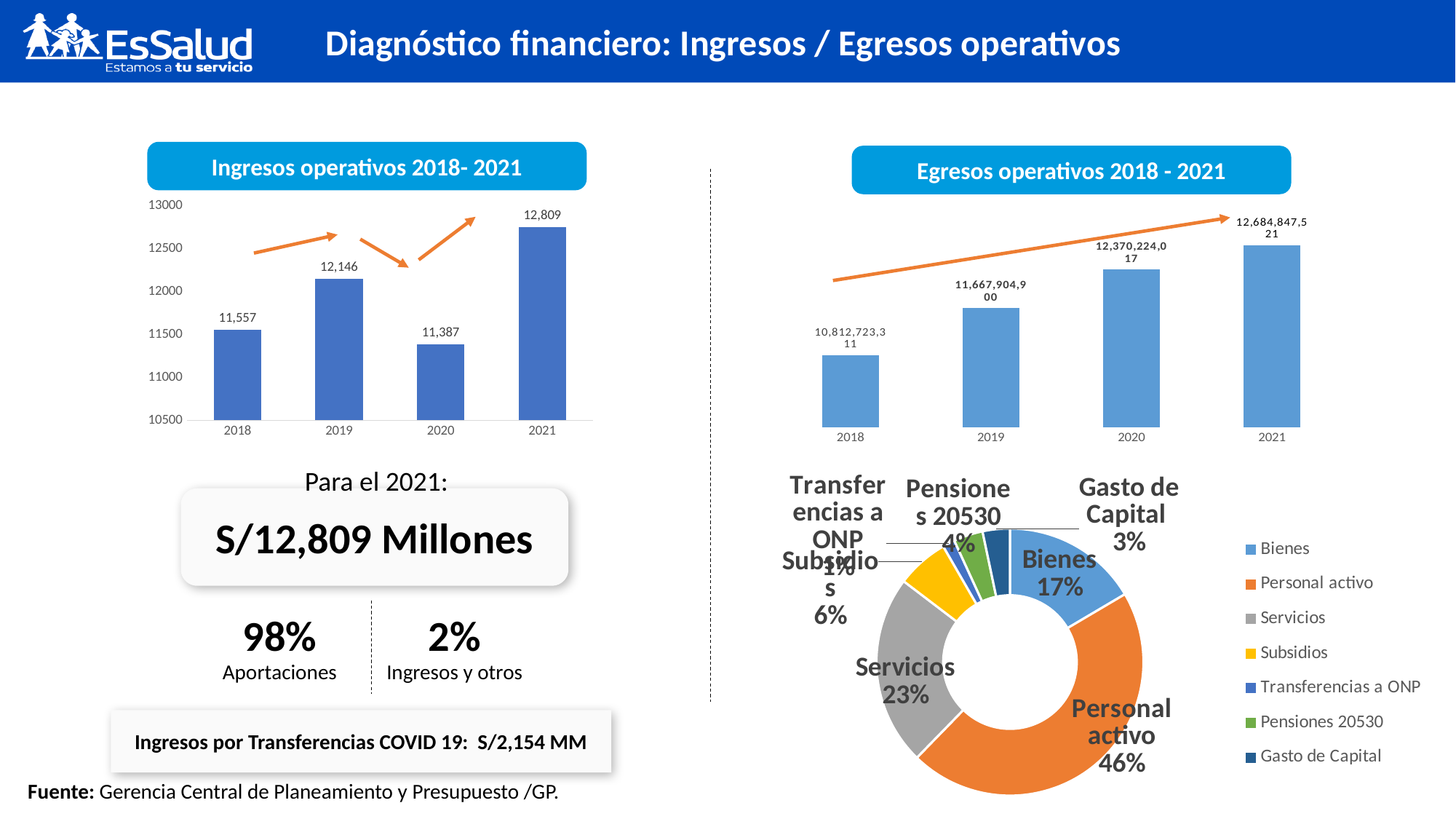
In the 'Ingresos operativos 2018- 2021' chart, which year has the highest value? 2021 What kind of chart is the 'Ingresos operativos 2018- 2021' chart? bar chart In the 'Ingresos operativos 2018- 2021' chart, which is larger, the value for 2019 or for 2020? 2019 In the 'Ingresos operativos 2018- 2021' chart, which year has the lowest value? 2020 In the donut chart at the bottom right, what share does 'Personal activo' have? 46% In the 'Egresos operativos 2018 - 2021' chart, what is the value for 2019? 11,667,904,900 In the 'Ingresos operativos 2018- 2021' chart, what is the value for 2020? 11,387 In the 'Ingresos operativos 2018- 2021' chart, what is the difference between the 2021 and 2018 values? 1,252 In the donut chart at the bottom right, which category has the smallest share? Transferencias a ONP How many entries does the legend of the donut chart at the bottom right list? 7 In the 'Egresos operativos 2018 - 2021' chart, do the values rise or fall from 2018 to 2021? rise How many bars are in the 'Egresos operativos 2018 - 2021' chart? 4